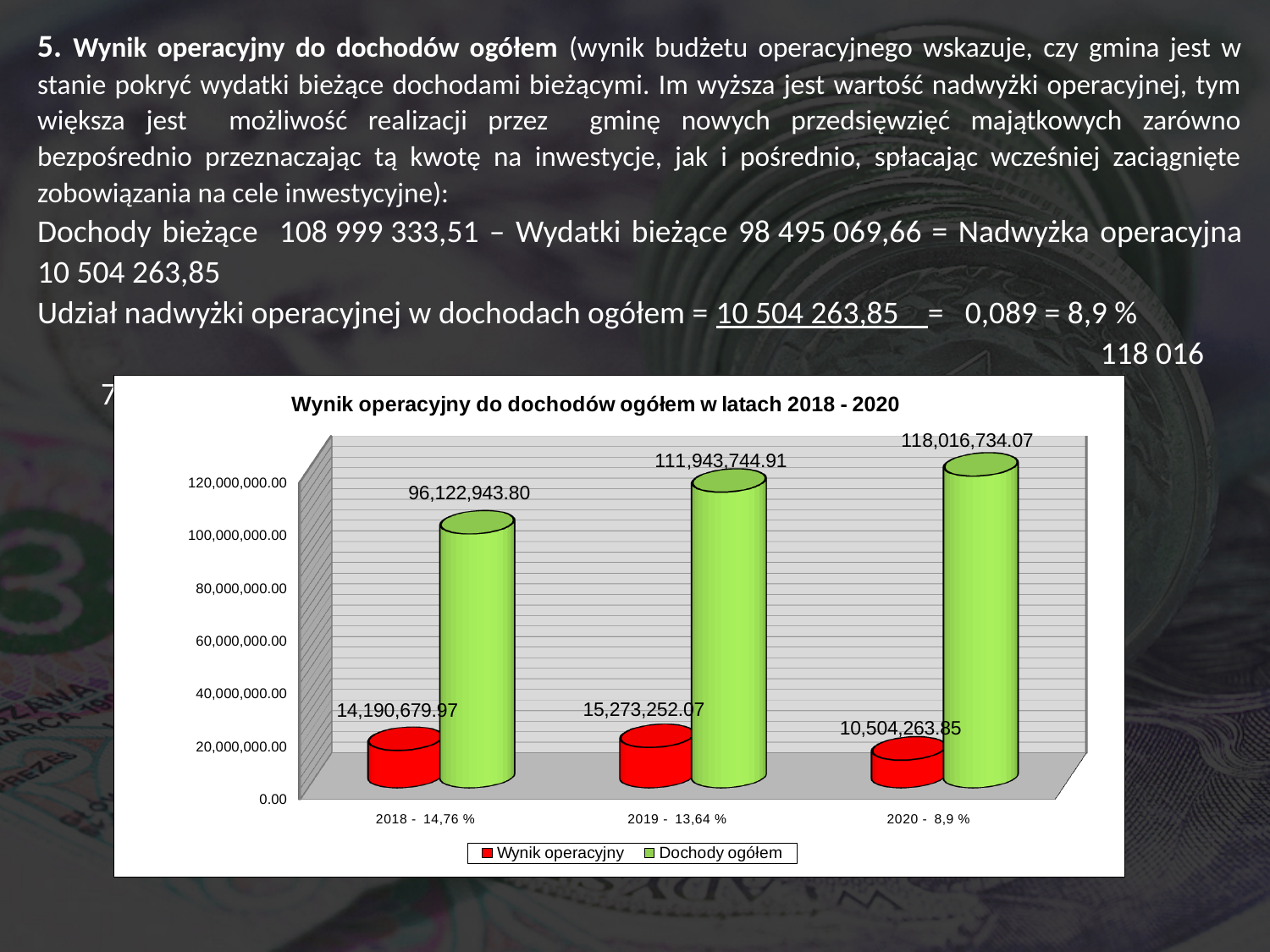
In which year is Wynik operacyjny the highest? 2019 Which is larger: Wynik operacyjny in 2019 or Wynik operacyjny in 2020? Wynik operacyjny in 2019 What is the value of Wynik operacyjny for 2018? 14,190,679.97 What type of chart is shown on the slide? bar chart What is the title of the chart? Wynik operacyjny do dochodów ogółem w latach 2018 - 2020 In which year is Dochody ogółem the lowest? 2018 What is the value of Dochody ogółem for 2020? 118,016,734.07 How many categories are shown on the x axis? 3 What is the difference between Dochody ogółem in 2019 and in 2018? 15,820,801.11 Does Dochody ogółem rise or fall from 2018 to 2020? rise What is the value of Dochody ogółem for 2019? 111,943,744.91 How many series does the legend list? 2